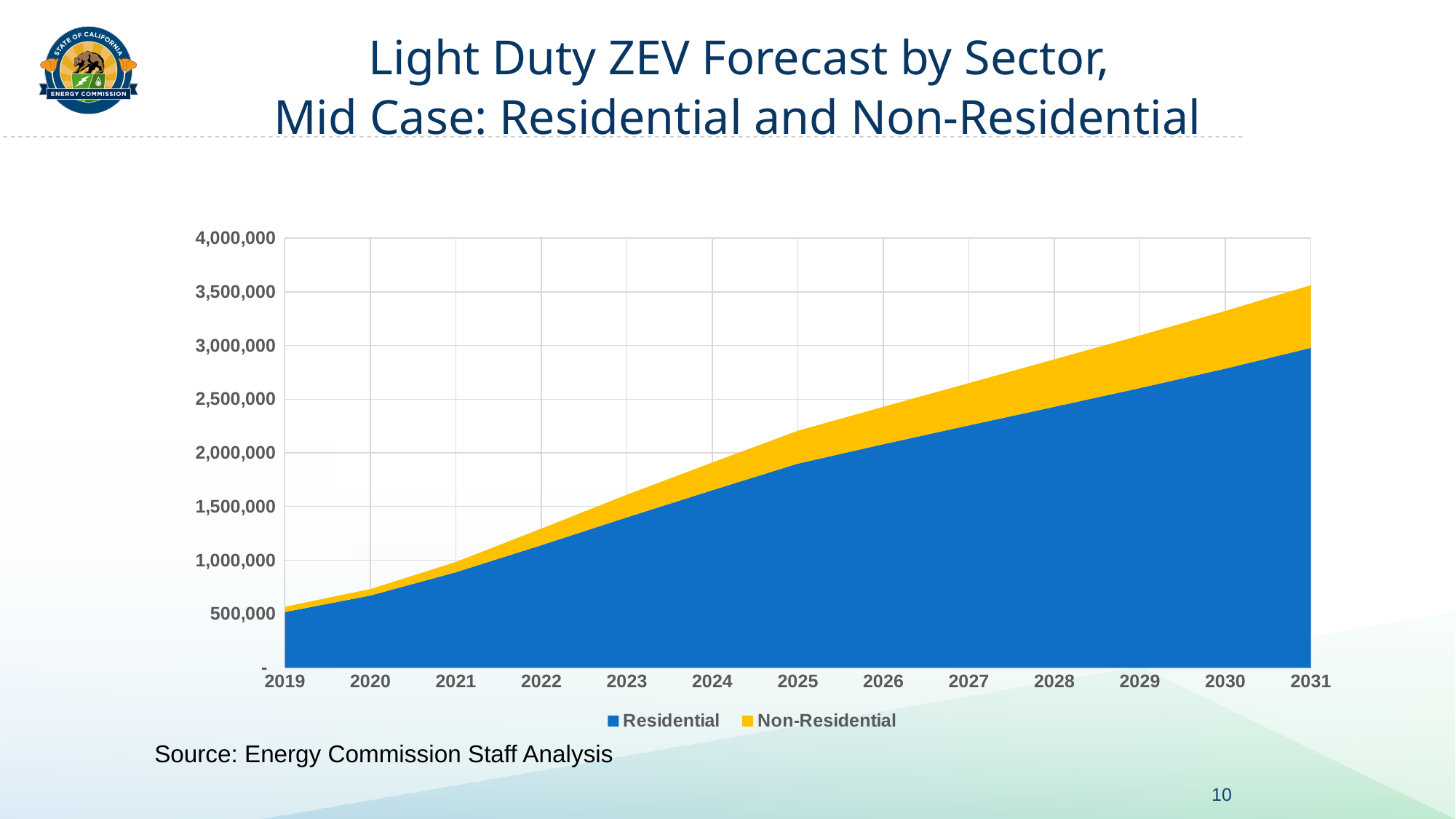
What kind of chart is shown on the slide? Stacked area chart What is the source cited below the chart? Energy Commission Staff Analysis In which year is the total light duty ZEV forecast lowest? 2019 How many series does the legend list? 2 Is the total (Residential plus Non-Residential) value for 2028 greater or less than 3,000,000? less How many years are shown along the x axis? 13 Do the total light duty ZEV values rise or fall from 2019 to 2031? Rise Which series is shown in yellow? Non-Residential In which year is the total light duty ZEV forecast highest? 2031 Is the total (Residential plus Non-Residential) value for 2031 greater or less than 3,500,000? greater In 2031, which series is larger, Residential or Non-Residential? Residential Is the Residential value for 2025 greater or less than 2,000,000? less